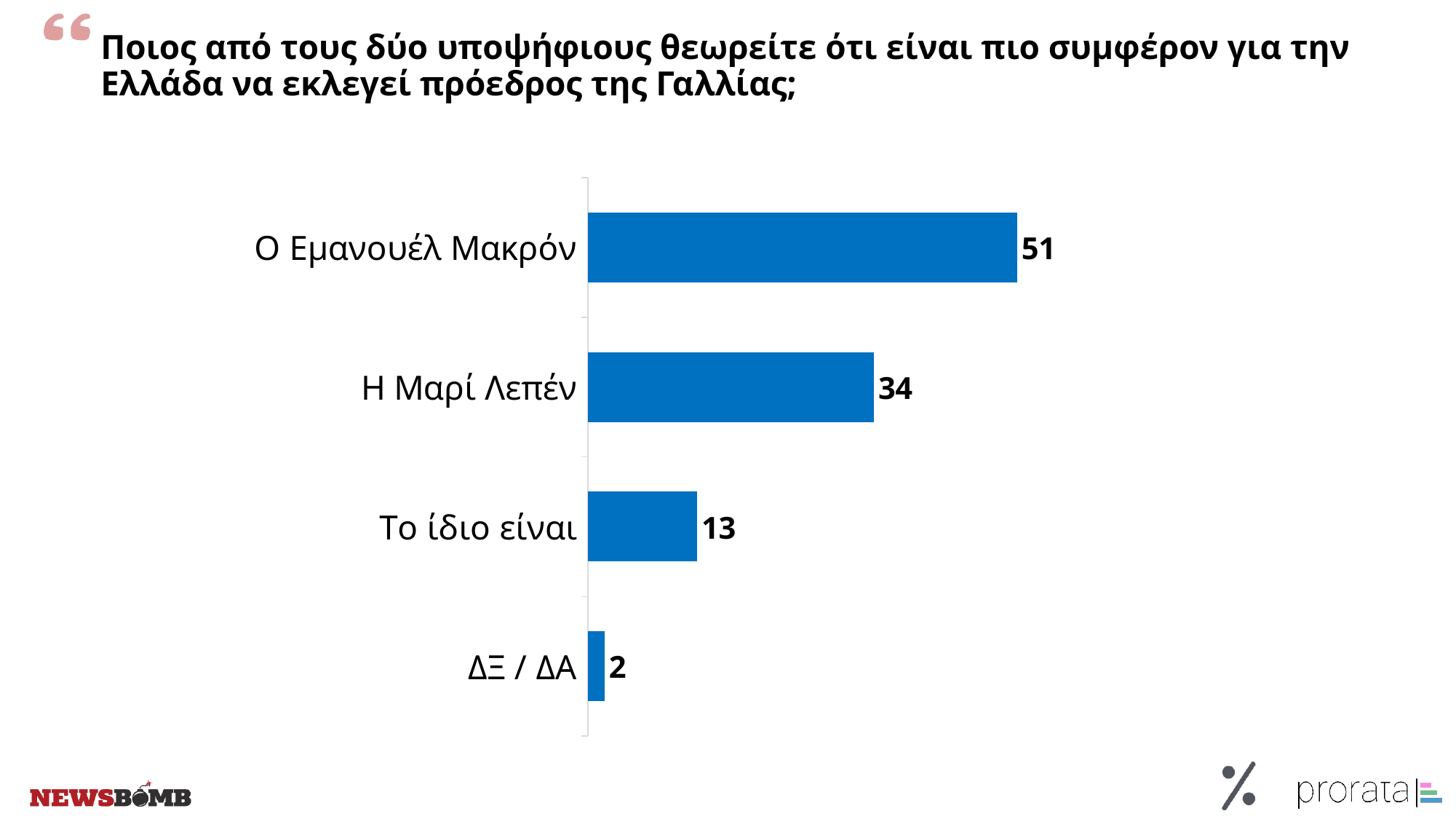
What value is shown for Το ίδιο είναι? 13 How many categories are shown in the chart? 4 Which category has the lowest value? ΔΞ / ΔΑ What value is shown for Ο Εμανουέλ Μακρόν? 51 What value is shown for Η Μαρί Λεπέν? 34 What value is shown for ΔΞ / ΔΑ? 2 What is the difference between the values for Ο Εμανουέλ Μακρόν and Η Μαρί Λεπέν? 17 Which is larger, the value for Η Μαρί Λεπέν or the value for Το ίδιο είναι? Η Μαρί Λεπέν What is the difference between the values for Η Μαρί Λεπέν and Το ίδιο είναι? 21 Which category has the highest value? Ο Εμανουέλ Μακρόν What kind of chart is shown on the slide? bar chart What colour are the bars in the chart? blue